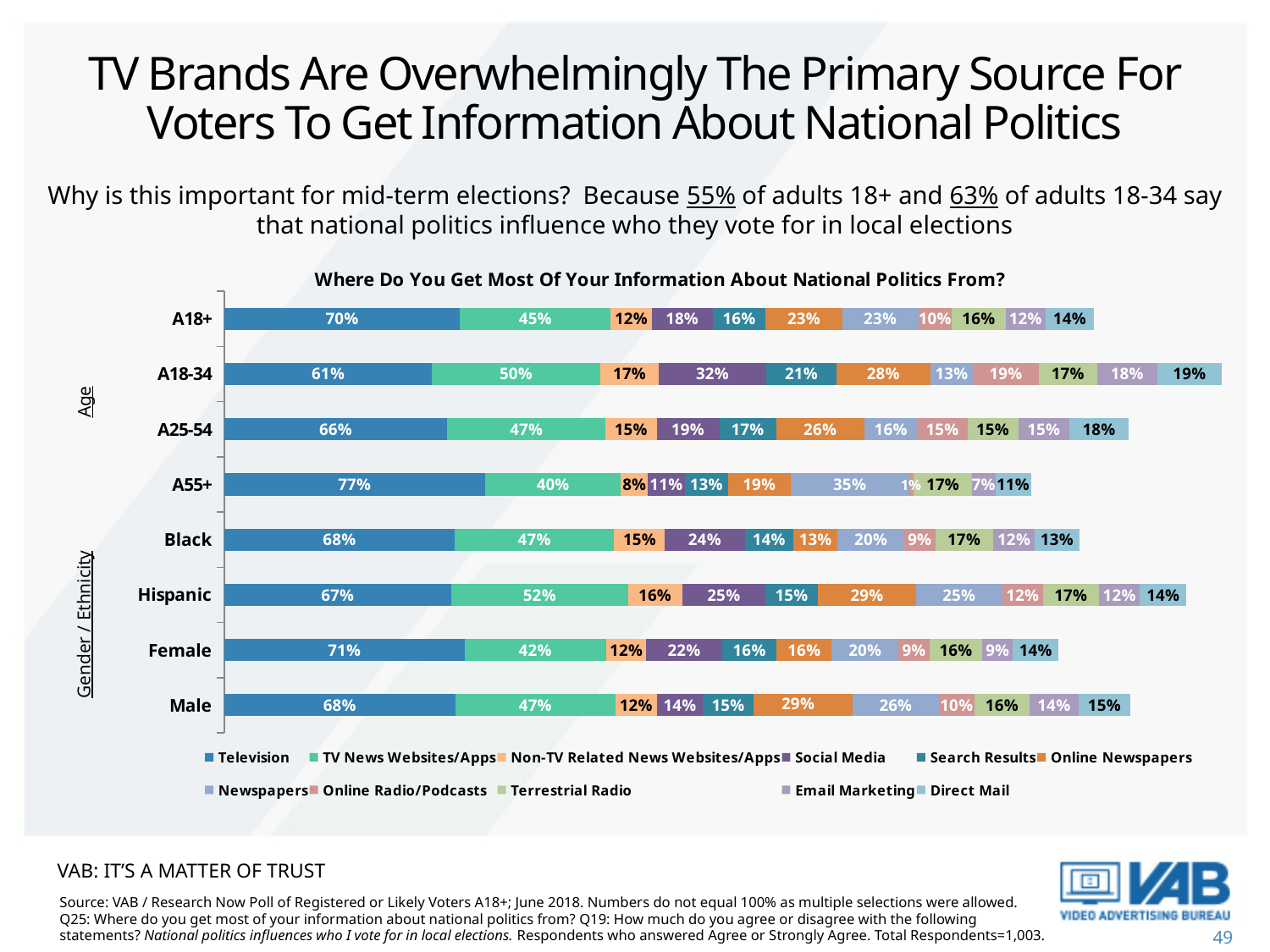
How many categories are shown on the y axis of the chart? 8 What is the Newspapers value for A55+? 35% Which category has the highest Television value? A55+ What is the title of the chart? Where Do You Get Most Of Your Information About National Politics From? What kind of chart is shown on the slide? Bar chart What percentage of A55+ respondents get most of their national politics information from Television? 77% What is the Social Media value for A18-34? 32% How many series does the legend list? 11 Which category has the lowest Television value? A18-34 What is the TV News Websites/Apps value for Hispanic respondents? 52% Which is larger, the Online Newspapers value for Male or for Female? Male What is the difference between the Television values for Female and Male? 3%